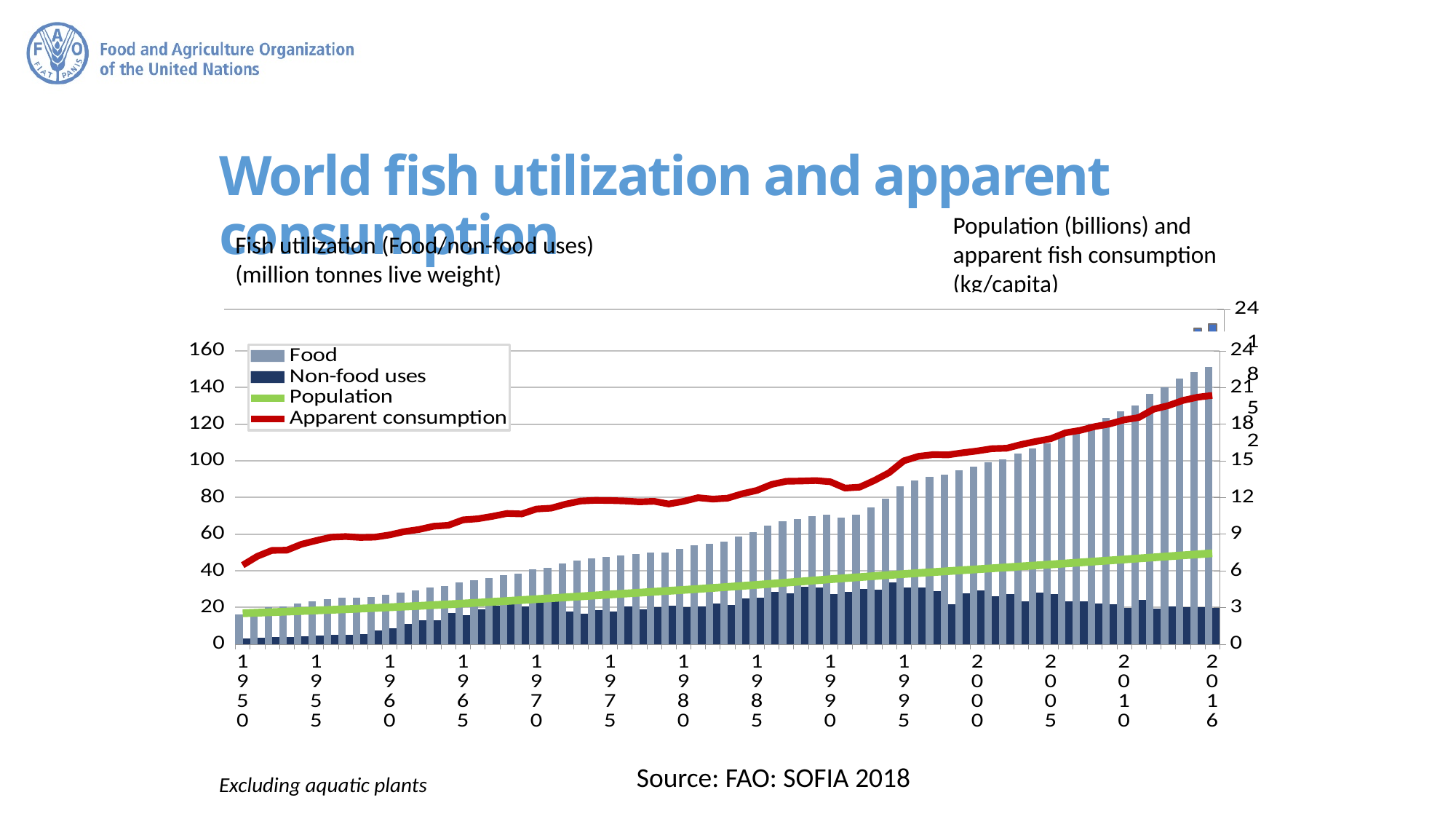
Which year has the shortest stacked bar? 1950 Does the Apparent consumption line rise or fall from 1950 to 2016? Rise Is the total height of the stacked bar for 1950 greater or less than 20 on the left axis? less In 2016, which segment is larger: Food or Non-food uses? Food Is the Apparent consumption value for 2016 greater or less than 18 on the right axis? greater What kind of chart is shown on the slide? Combination bar and line chart How many series does the chart legend list? 4 What does the left-hand axis of the chart measure, according to its label? Fish utilization (Food/non-food uses) (million tonnes live weight) Is the total height of the stacked bar for 2016 greater or less than 140 on the left axis? greater Does the Population line rise or fall across the years shown? Rise What is the title of the slide's chart? World fish utilization and apparent consumption